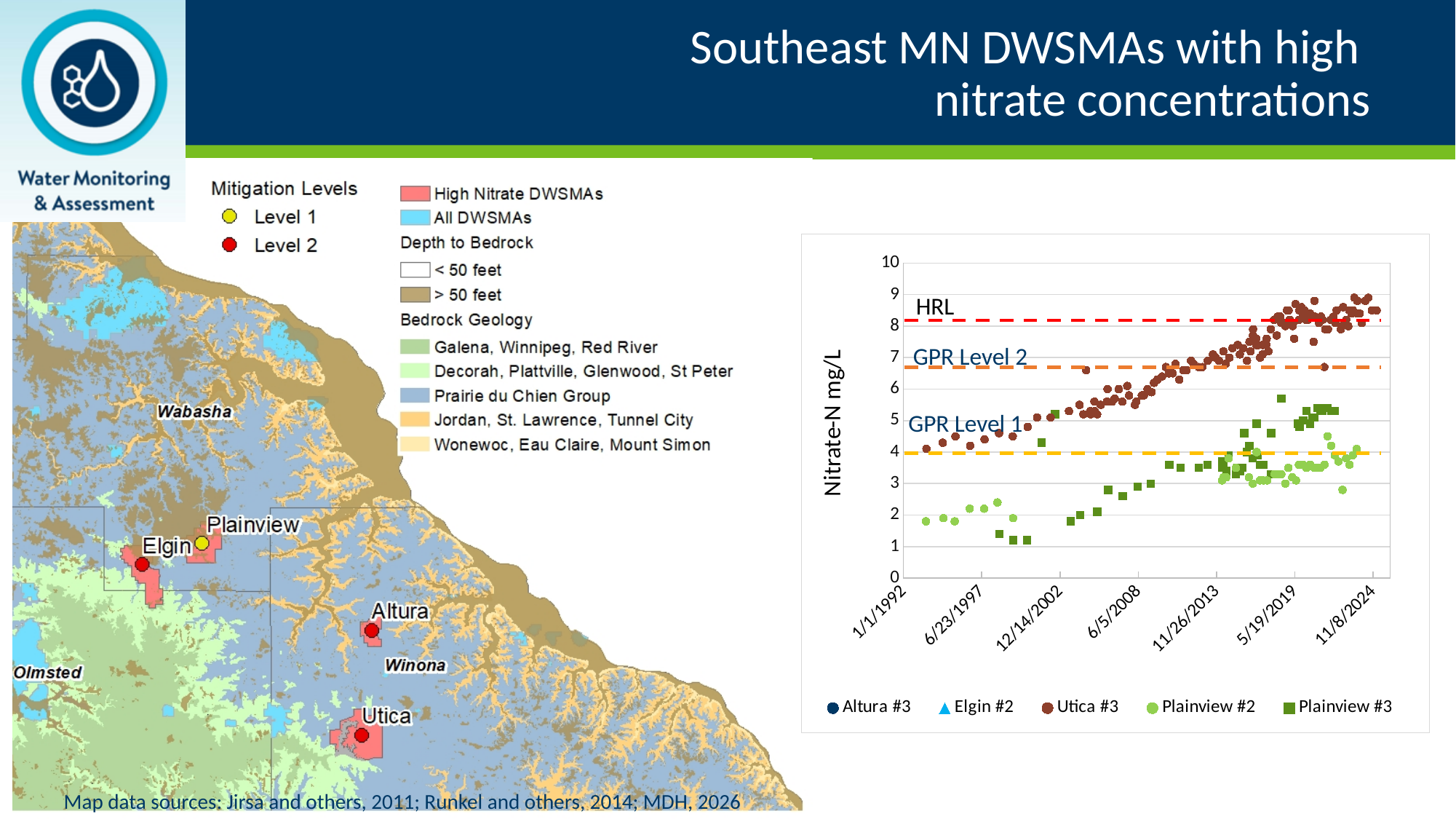
What is the y-axis label of the nitrate chart? Nitrate-N mg/L In the nitrate chart, around 2024, which series has higher values: Utica #3 or Plainview #2? Utica #3 In the nitrate chart, do the Plainview #3 values rise or fall over time? rise In the nitrate chart, are the earliest Plainview #2 values greater or less than 3 mg/L? less In the nitrate chart, which series reaches the highest nitrate values? Utica #3 What kind of chart is shown on the right side of the slide? scatter chart What are the three labelled horizontal reference lines on the nitrate chart? HRL, GPR Level 2, GPR Level 1 How many series does the legend of the nitrate chart list? 5 What is the first date tick on the x-axis of the nitrate chart? 1/1/1992 In the nitrate chart, do the Utica #3 values rise or fall over time? rise In the nitrate chart, are the most recent Utica #3 values greater or less than 7 mg/L? greater What is the last date tick on the x-axis of the nitrate chart? 11/8/2024